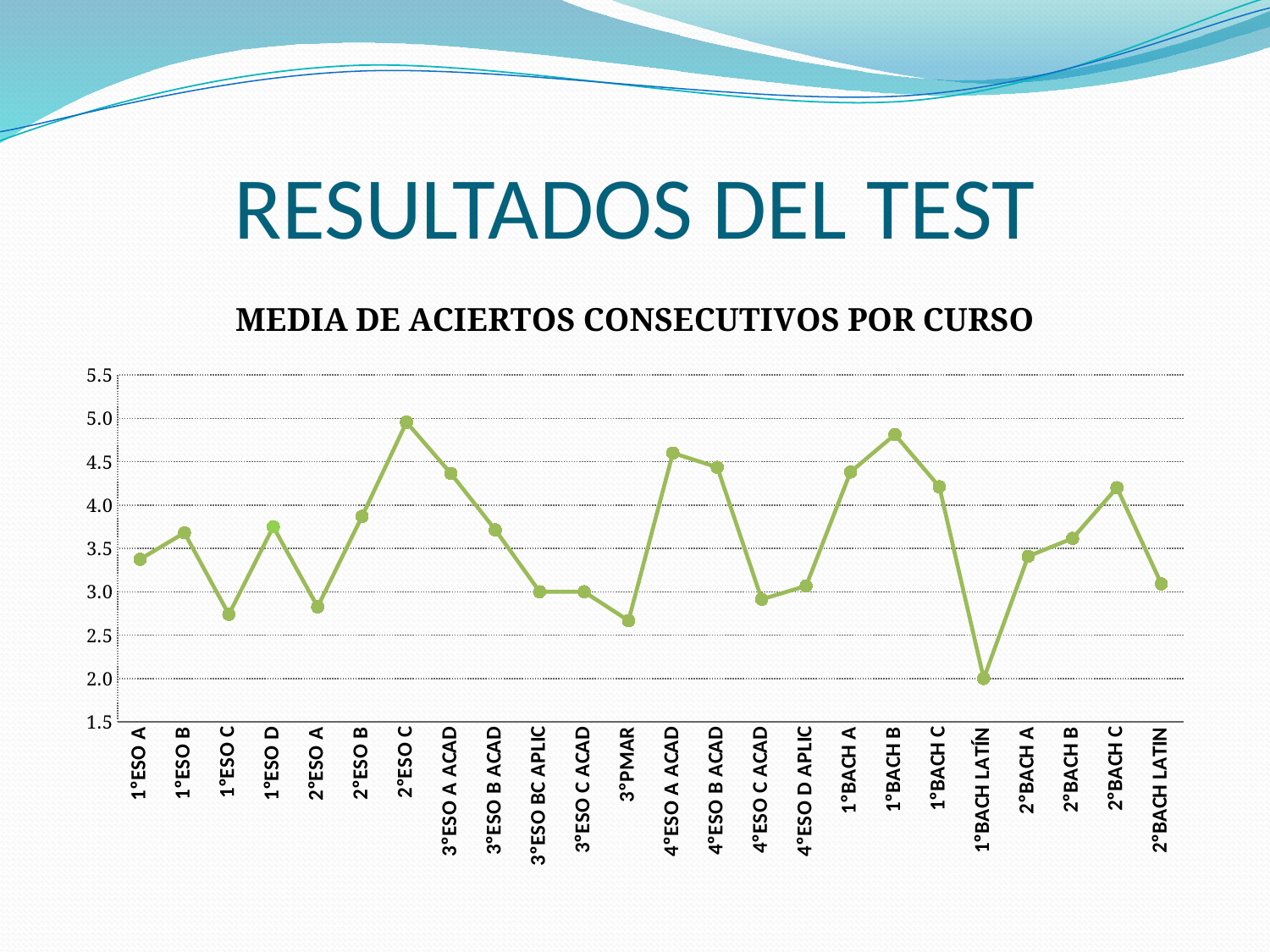
What is the value for 1°BACH LATÍN? 2.0 Which is larger, the value for 2°ESO C or the value for 3°PMAR? 2°ESO C Which course has the lowest value? 1°BACH LATÍN What kind of chart is shown on the slide? line chart Is the value for 2°ESO C greater or less than 4.5? greater Is the value for 3°PMAR greater or less than 3.0? less Is the value for 1°ESO C greater or less than 3.0? less Do the values rise or fall from 1°BACH B to 1°BACH LATÍN? fall What is the title of the chart? MEDIA DE ACIERTOS CONSECUTIVOS POR CURSO Which is larger, the value for 1°ESO D or the value for 1°ESO C? 1°ESO D How many courses (categories) are plotted along the x axis? 24